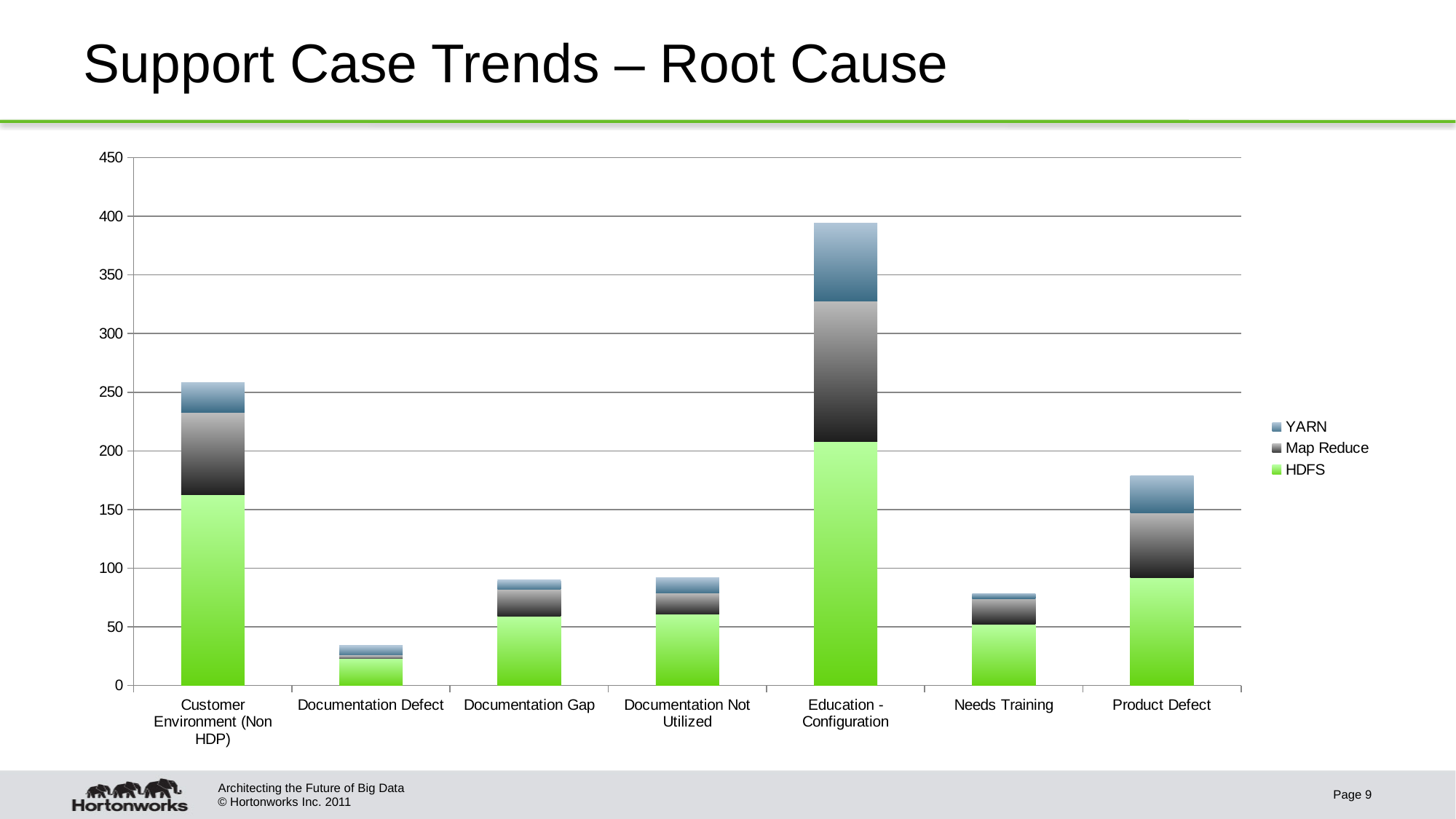
Which has a taller total bar, Customer Environment (Non HDP) or Product Defect? Customer Environment (Non HDP) Which category has the tallest stacked bar? Education - Configuration How many series does the legend list? 3 Is the total value for Documentation Defect greater or less than 50? less Is the total value for Product Defect greater or less than 200? less What kind of chart is shown on the slide? Stacked bar chart What is the title of the slide containing the chart? Support Case Trends – Root Cause Which category has the shortest stacked bar? Documentation Defect Is the total value for Education - Configuration greater or less than 350? greater How many root cause categories are shown on the x axis? 7 Which series is shown in green in the legend? HDFS